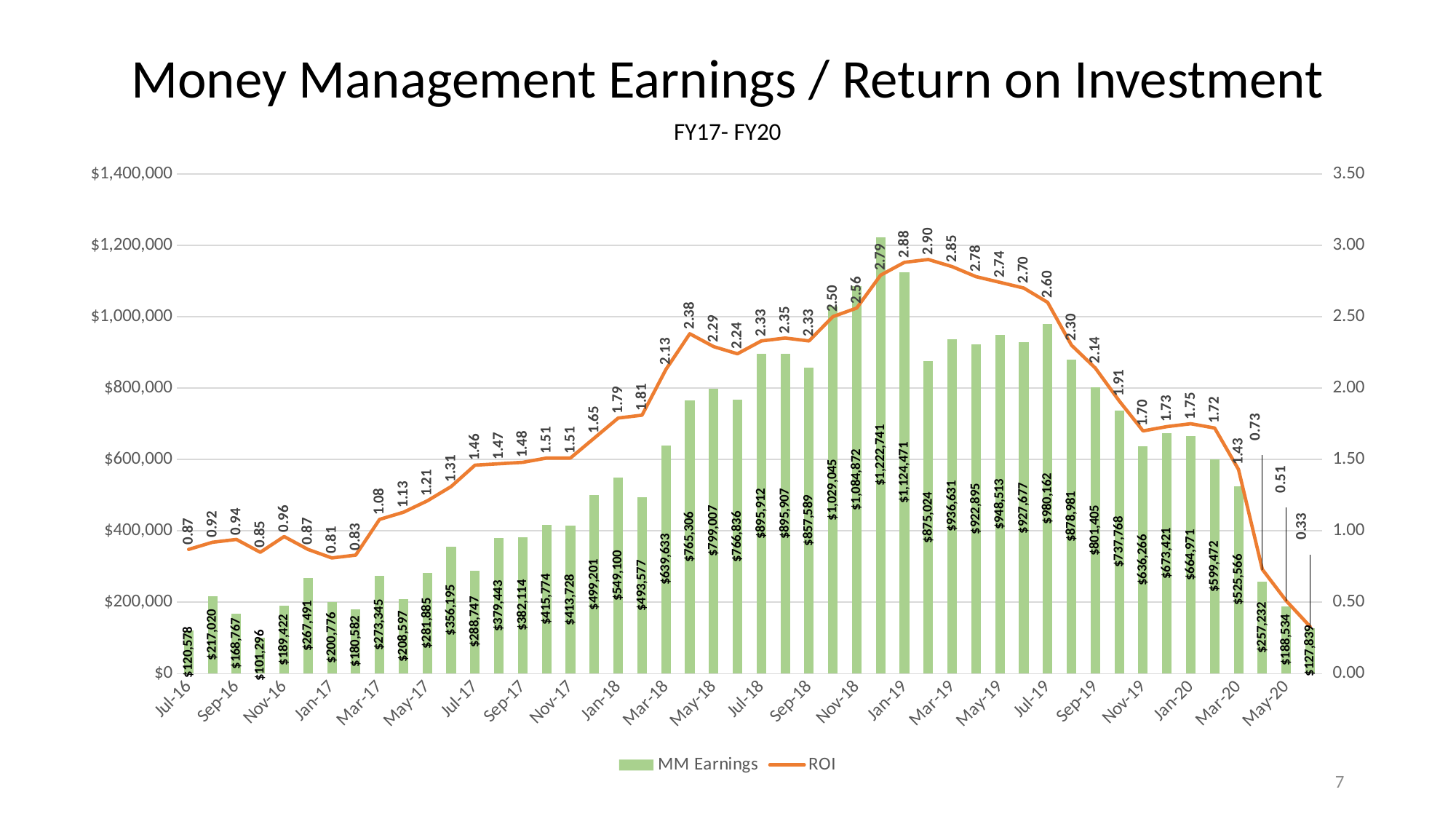
Does the ROI line rise or fall from Jul-19 to May-20? Fall What is the lowest ROI value shown on the chart? 0.33 What is the difference between MM Earnings for Jan-19 and Jan-20? $459,500 Is the MM Earnings value for Nov-18 greater or less than $1,000,000? greater Which has higher MM Earnings, Mar-18 or Mar-19? Mar-19 What is the MM Earnings value for Jul-19? $980,162 What is the ROI value for May-20? 0.51 How many series does the legend list? 2 What kind of chart is this? Combined bar and line chart What is the ROI value for Jan-19? 2.88 What is the highest MM Earnings value shown on the chart? $1,222,741 What is the MM Earnings value for Jul-16? $120,578